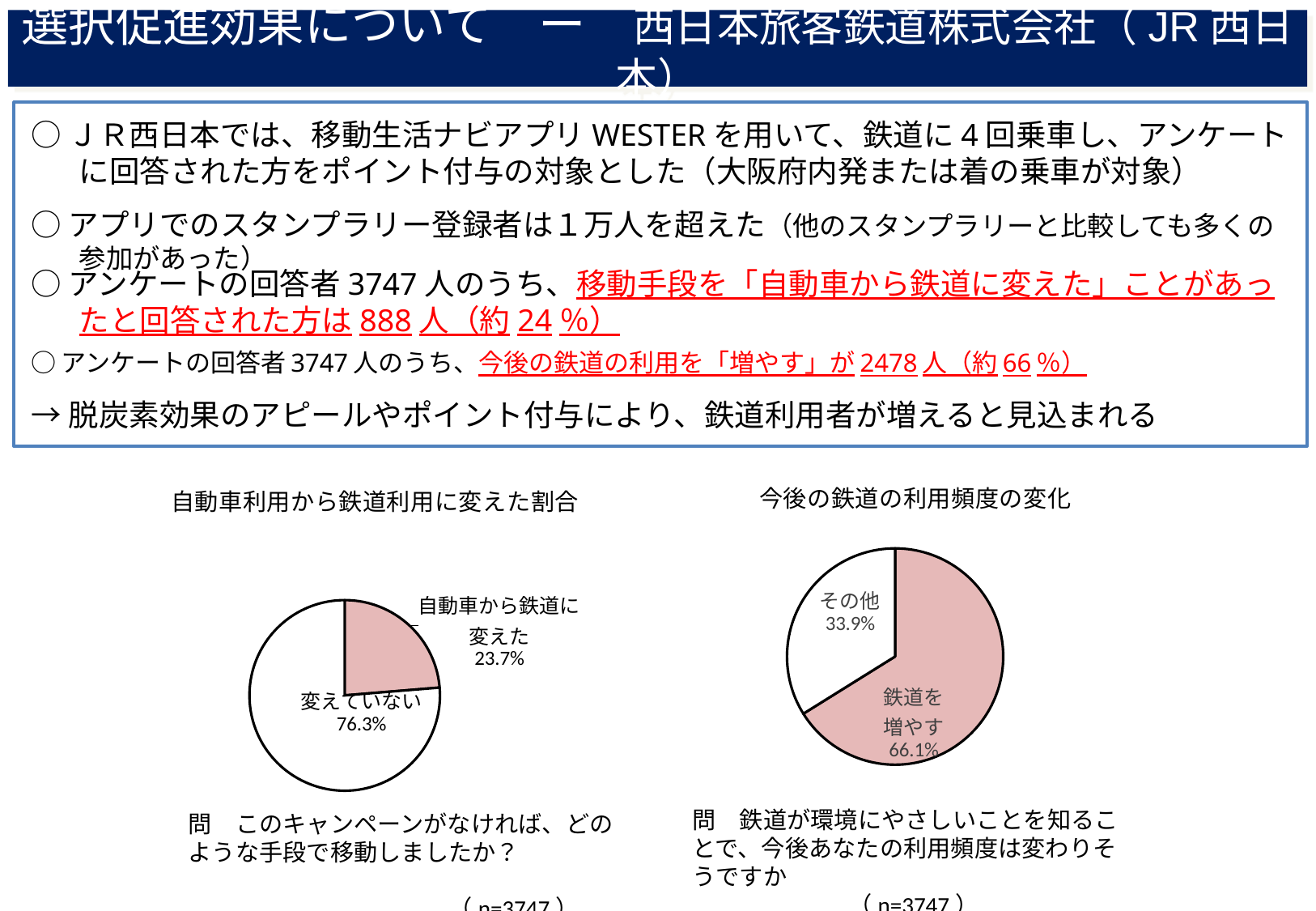
In the right pie chart titled 今後の鉄道の利用頻度の変化, what share is labelled 鉄道を増やす? 66.1% In the right pie chart, what is the difference in percentage points between 鉄道を増やす and その他? 32.2 In the right pie chart titled 今後の鉄道の利用頻度の変化, what share is labelled その他? 33.9% In the right pie chart, which slice is the smallest? その他 In the left pie chart titled 自動車利用から鉄道利用に変えた割合, what share is labelled 変えた? 23.7% How many slices does the left pie chart have? 2 What is the title of the left chart? 自動車利用から鉄道利用に変えた割合 In the left pie chart, which slice is the largest? 変えていない What type of chart is the right chart titled 今後の鉄道の利用頻度の変化? pie chart In the left pie chart, what is the difference in percentage points between 変えていない and 変えた? 52.6 In the left pie chart titled 自動車利用から鉄道利用に変えた割合, what share is labelled 変えていない? 76.3% Which is larger: the 変えた share in the left pie chart or the 鉄道を増やす share in the right pie chart? 鉄道を増やす